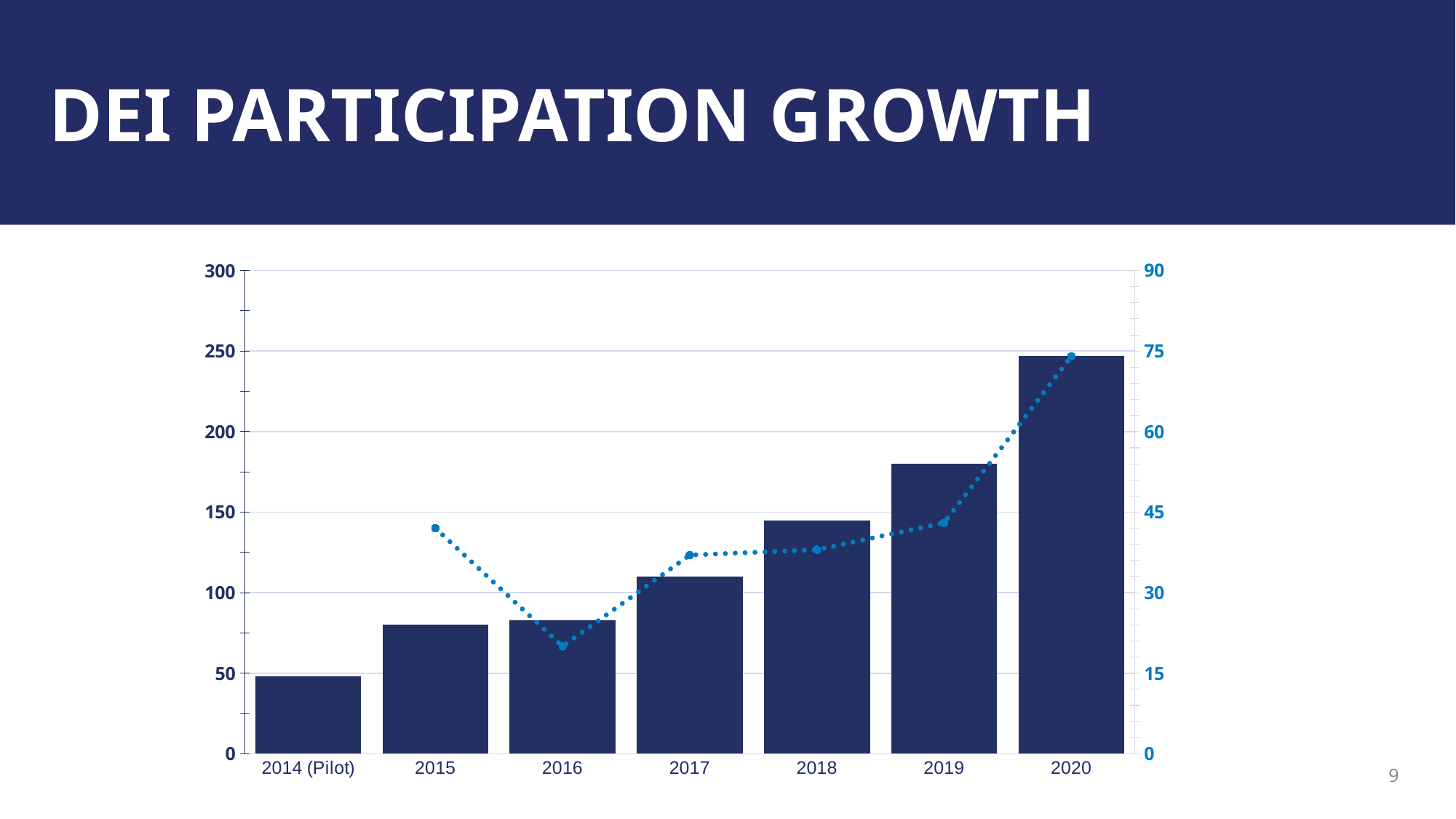
Is the dotted line value for 2020 greater or less than 60 on the right axis? greater Do the bar values rise or fall from 2014 (Pilot) to 2020? rise Which year has the tallest bar? 2020 Is the bar value for 2015 greater or less than 100 on the left axis? less Which bar is taller, 2019 or 2017? 2019 What is the title of the slide containing the chart? DEI PARTICIPATION GROWTH Is the bar value for 2017 greater or less than 100 on the left axis? greater What kind of chart is shown on the slide? bar chart with a dotted line Which category has the shortest bar? 2014 (Pilot) In which year does the dotted line reach its lowest point? 2016 How many categories are shown on the x axis? 7